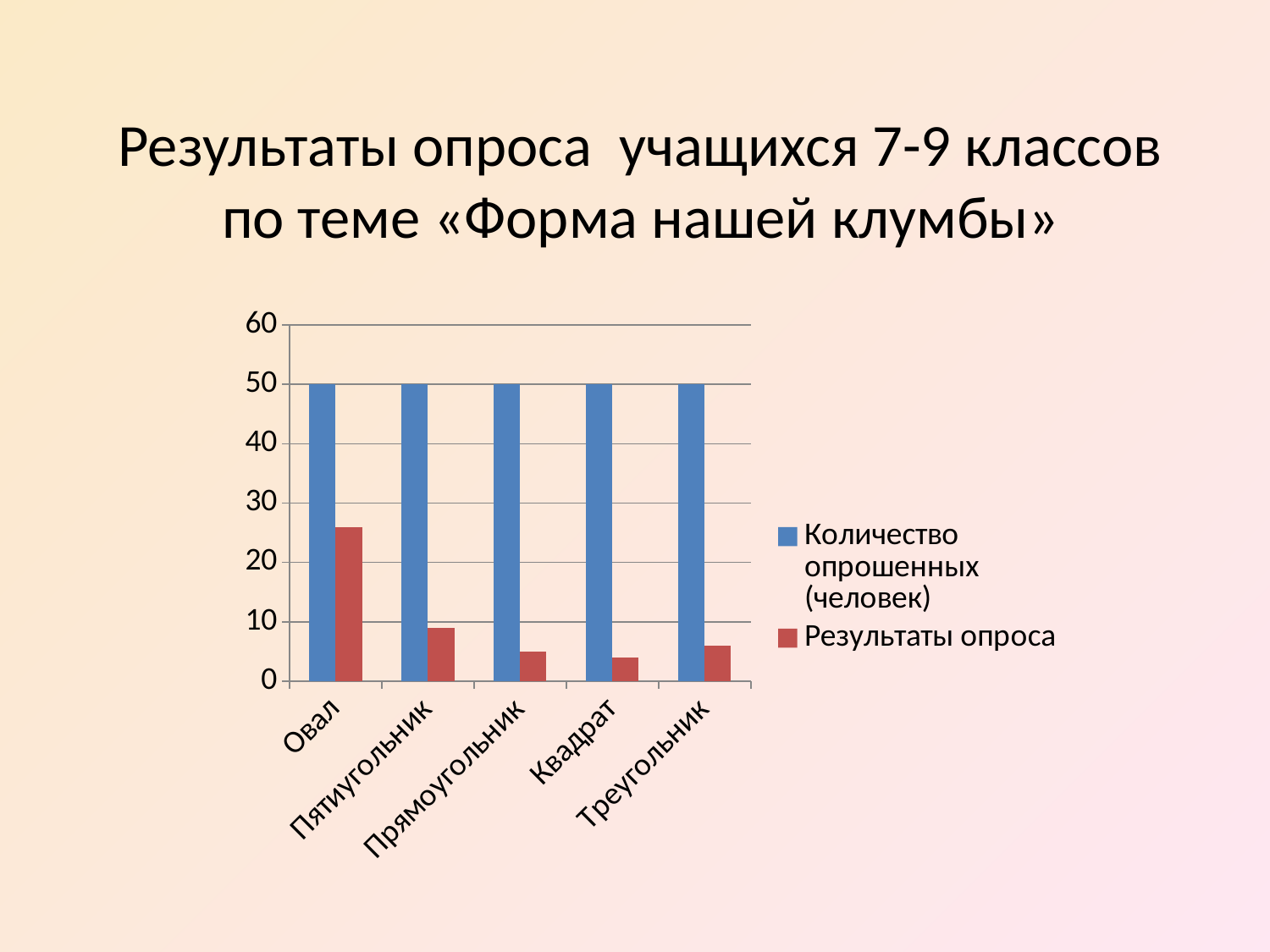
Is the value of "Результаты опроса" for Квадрат greater or less than 10? less How many series does the chart legend list? 2 Which is larger for "Результаты опроса": Овал or Пятиугольник? Овал What is the value of "Количество опрошенных (человек)" for Квадрат? 50 Which category has the highest value for "Результаты опроса"? Овал Is the value of "Результаты опроса" for Овал greater or less than 20? greater Is the value of "Результаты опроса" for Овал greater or less than 30? less How many categories are shown on the x axis of the chart? 5 What kind of chart is shown on the slide? Bar chart What is the value of "Количество опрошенных (человек)" for Овал? 50 Which colour represents the series "Результаты опроса" in the chart? Red